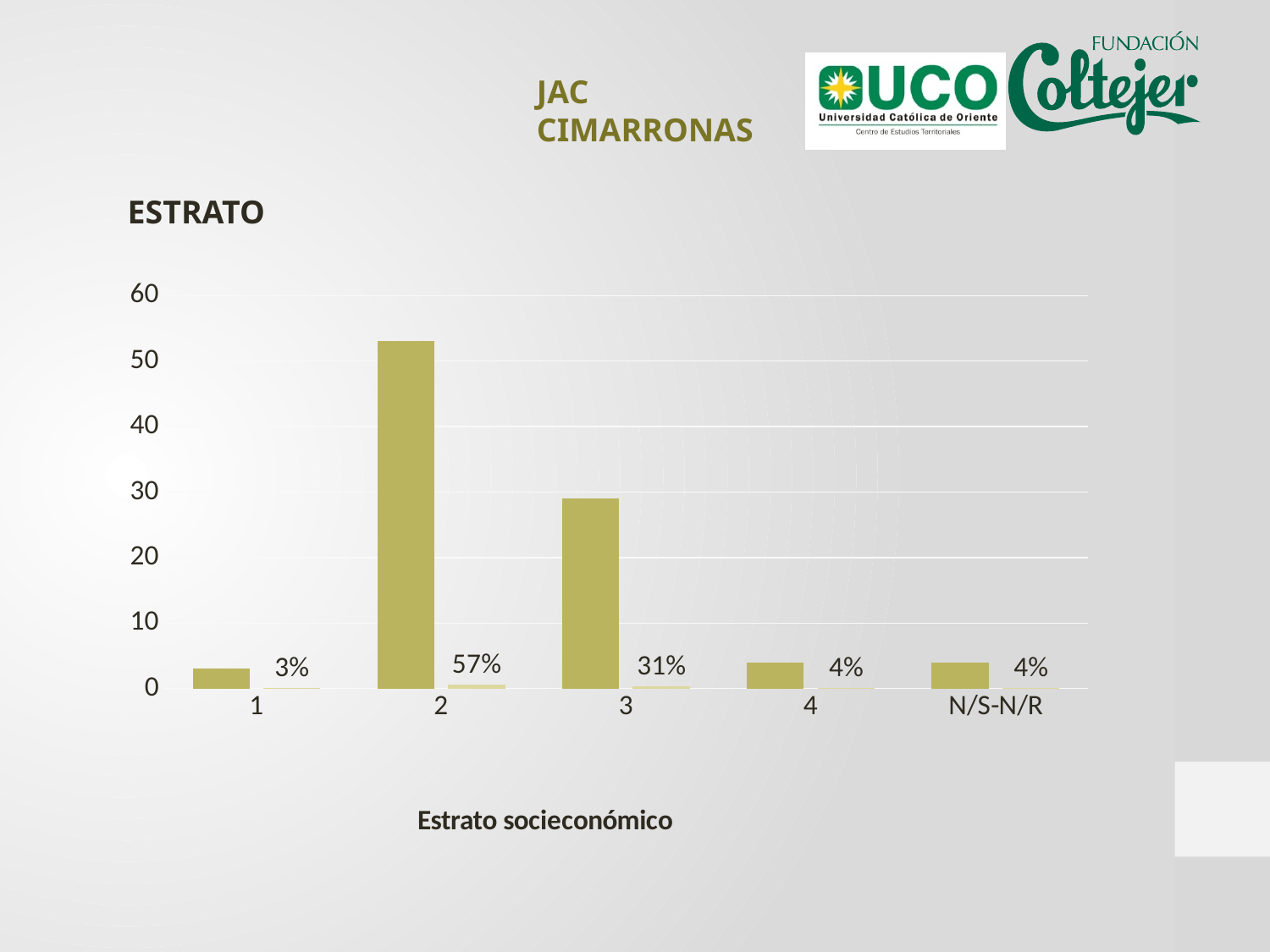
Which has a larger value, category 3 or category 4? 3 What percentage label is shown for category 1? 3% What is the difference in percentage points between the labels for category 2 and category 3? 26% How many categories are shown on the x axis? 5 Is the bar for category 2 greater or less than 50 on the vertical axis? greater What percentage label is shown for the N/S-N/R category? 4% What percentage label is shown for category 3? 31% Which category has the highest bar? 2 What kind of chart is shown on the slide? bar chart What percentage label is shown for category 2? 57% Which category has the lowest percentage label? 1 Is the bar for category 1 greater or less than 10 on the vertical axis? less